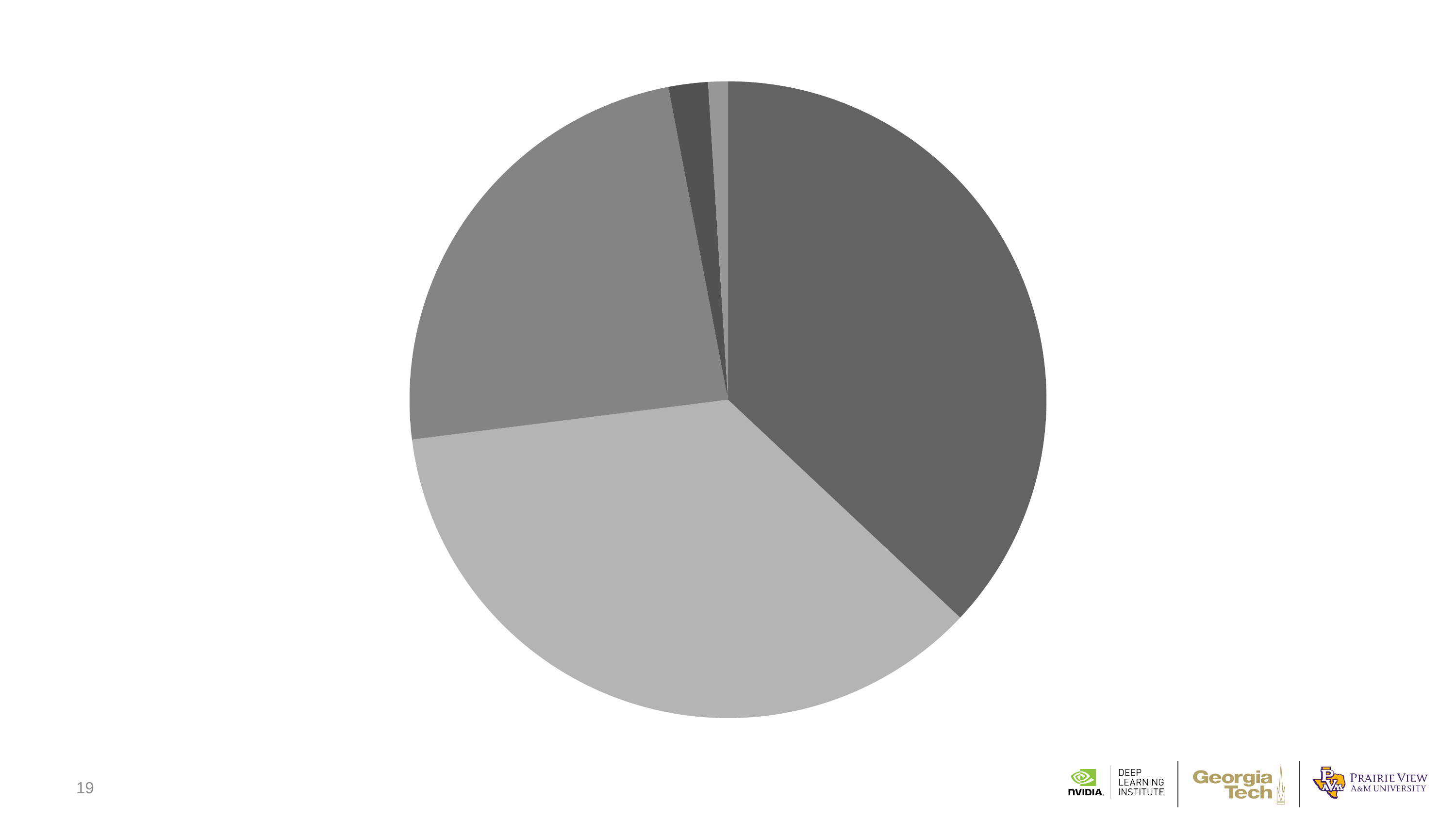
Which is larger in the pie chart: the dark grey slice on the right or the medium grey slice at the top left? the dark grey slice on the right Which is larger in the pie chart: the light grey slice at the bottom or the thin slice at the top? the light grey slice at the bottom Does the pie chart have a legend? No What kind of chart is shown on the slide? pie chart How many slices does the pie chart have? 5 Does the pie chart show data labels on its slices? No